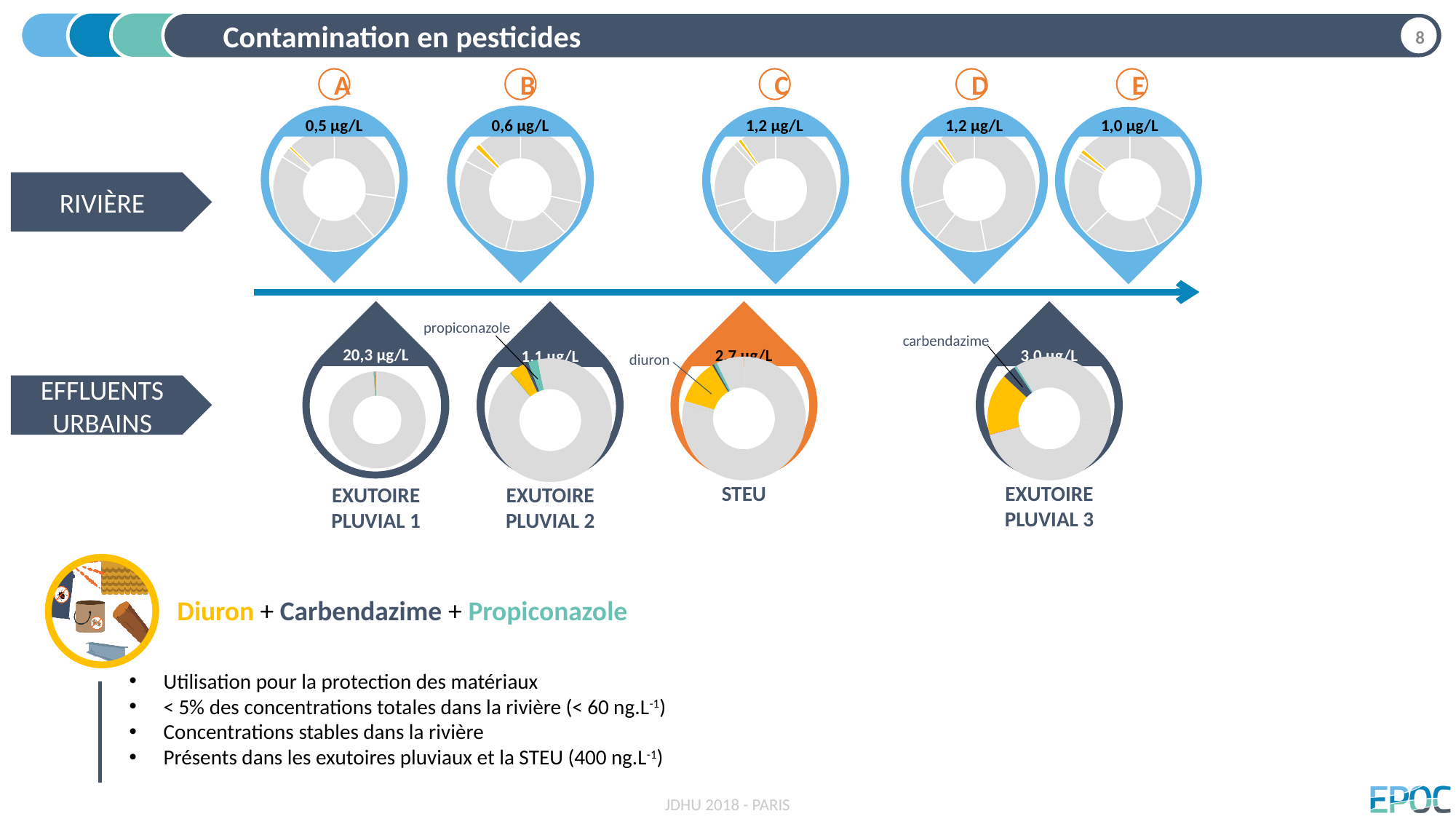
What concentration is printed on the EXUTOIRE PLUVIAL 1 chart? 20,3 µg/L What total concentration is printed above the river chart for site A? 0,5 µg/L Which has the larger printed concentration, STEU or EXUTOIRE PLUVIAL 3? EXUTOIRE PLUVIAL 3 What is the difference between the printed concentrations for river sites B and A? 0,1 µg/L Which pesticide is labelled on the STEU chart? diuron What total concentration is printed above the river chart for site C? 1,2 µg/L What kind of chart is used for each site on the slide? Donut (pie) chart Among the urban effluent charts, which site has the highest printed concentration? EXUTOIRE PLUVIAL 1 What concentration is printed on the STEU chart? 2,7 µg/L How many river site charts (RIVIÈRE row) are shown on the slide? 5 What concentration is printed on the EXUTOIRE PLUVIAL 3 chart? 3,0 µg/L Among the river sites A to E, which has the lowest printed concentration? A